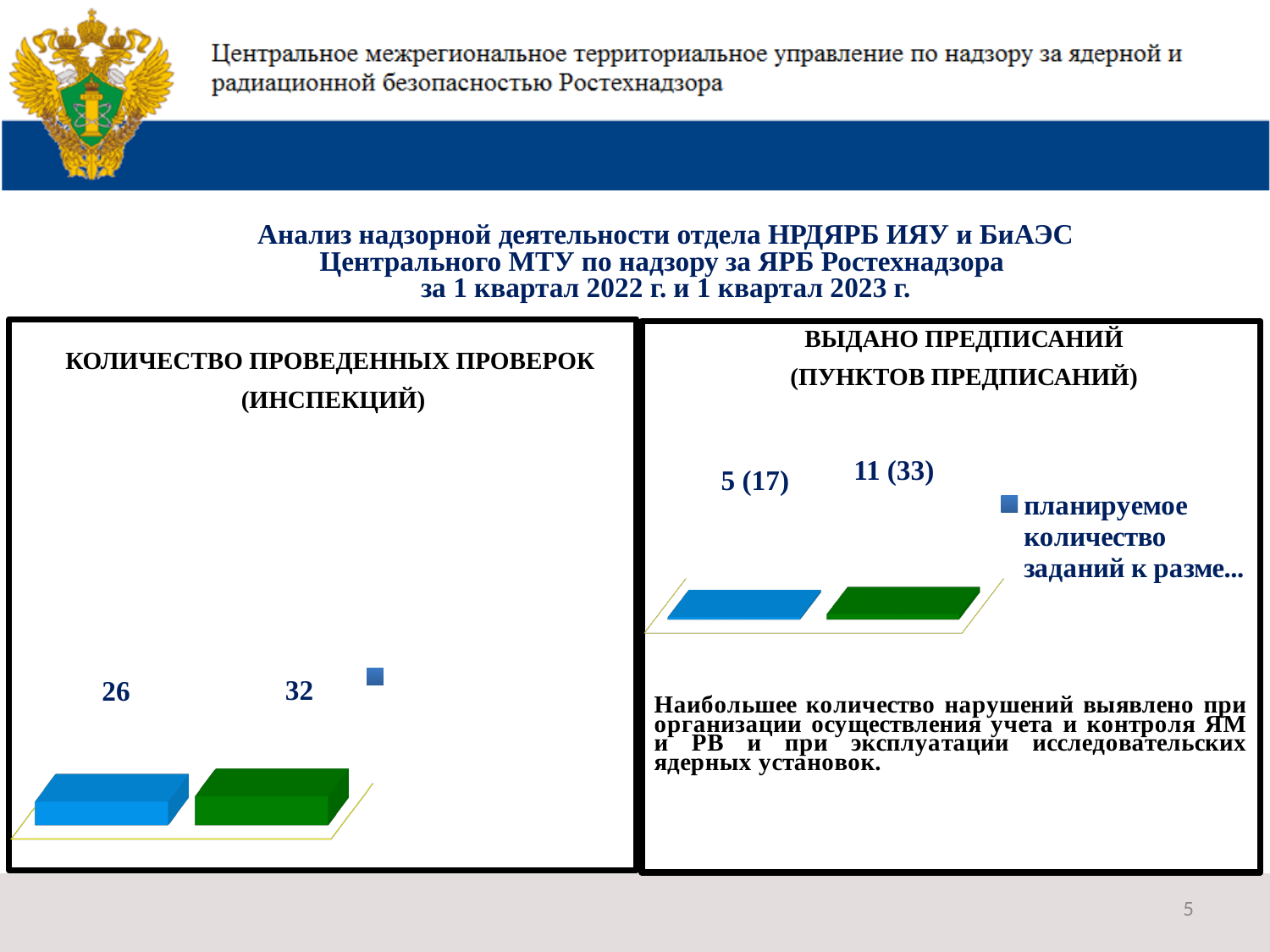
In the left chart (КОЛИЧЕСТВО ПРОВЕДЕННЫХ ПРОВЕРОК), what is the difference between the green bar and the blue bar? 6 How many bars are plotted in the right chart (ВЫДАНО ПРЕДПИСАНИЙ)? 2 In the left chart (КОЛИЧЕСТВО ПРОВЕДЕННЫХ ПРОВЕРОК), what value is shown on the green bar? 32 In the left chart (КОЛИЧЕСТВО ПРОВЕДЕННЫХ ПРОВЕРОК), what value is shown on the blue bar? 26 In the right chart (ВЫДАНО ПРЕДПИСАНИЙ), what label is shown above the green bar? 11 (33) In the right chart (ВЫДАНО ПРЕДПИСАНИЙ), which bar is larger, the blue one or the green one? the green bar In the right chart (ВЫДАНО ПРЕДПИСАНИЙ), what is the difference between the first numbers on the green bar (11) and the blue bar (5)? 6 In the left chart (КОЛИЧЕСТВО ПРОВЕДЕННЫХ ПРОВЕРОК), which bar is higher, the blue one or the green one? the green bar How many bars are plotted in the left chart (КОЛИЧЕСТВО ПРОВЕДЕННЫХ ПРОВЕРОК)? 2 In the right chart (ВЫДАНО ПРЕДПИСАНИЙ), what label is shown above the blue bar? 5 (17) What is the title of the chart on the right side of the slide? ВЫДАНО ПРЕДПИСАНИЙ (ПУНКТОВ ПРЕДПИСАНИЙ) What kind of chart is the left chart (КОЛИЧЕСТВО ПРОВЕДЕННЫХ ПРОВЕРОК)? bar chart